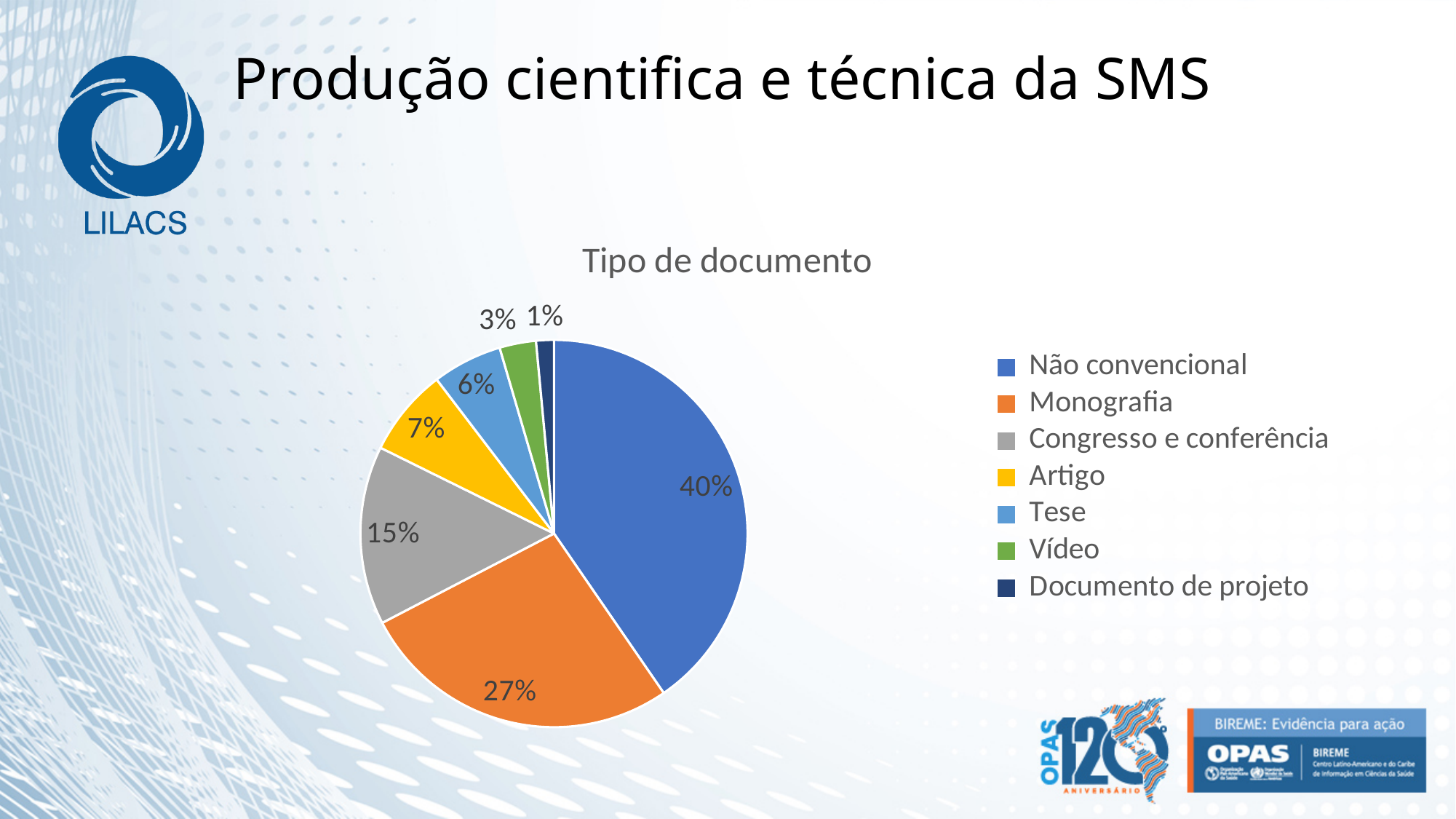
What is the difference in percentage points between Não convencional and Monografia? 13 What share of the pie does Não convencional represent? 40% How many document types are shown in the pie chart? 7 Which document type has the smallest slice of the pie? Documento de projeto Which is larger, the share for Artigo or the share for Tese? Artigo Which colour represents Vídeo in the legend? Green What is the title of the chart? Tipo de documento Which document type has the largest slice of the pie? Não convencional What is the value shown for Tese? 6% What is the value shown for Monografia? 27% What kind of chart is shown on the slide? Pie chart What is the value shown for Congresso e conferência? 15%